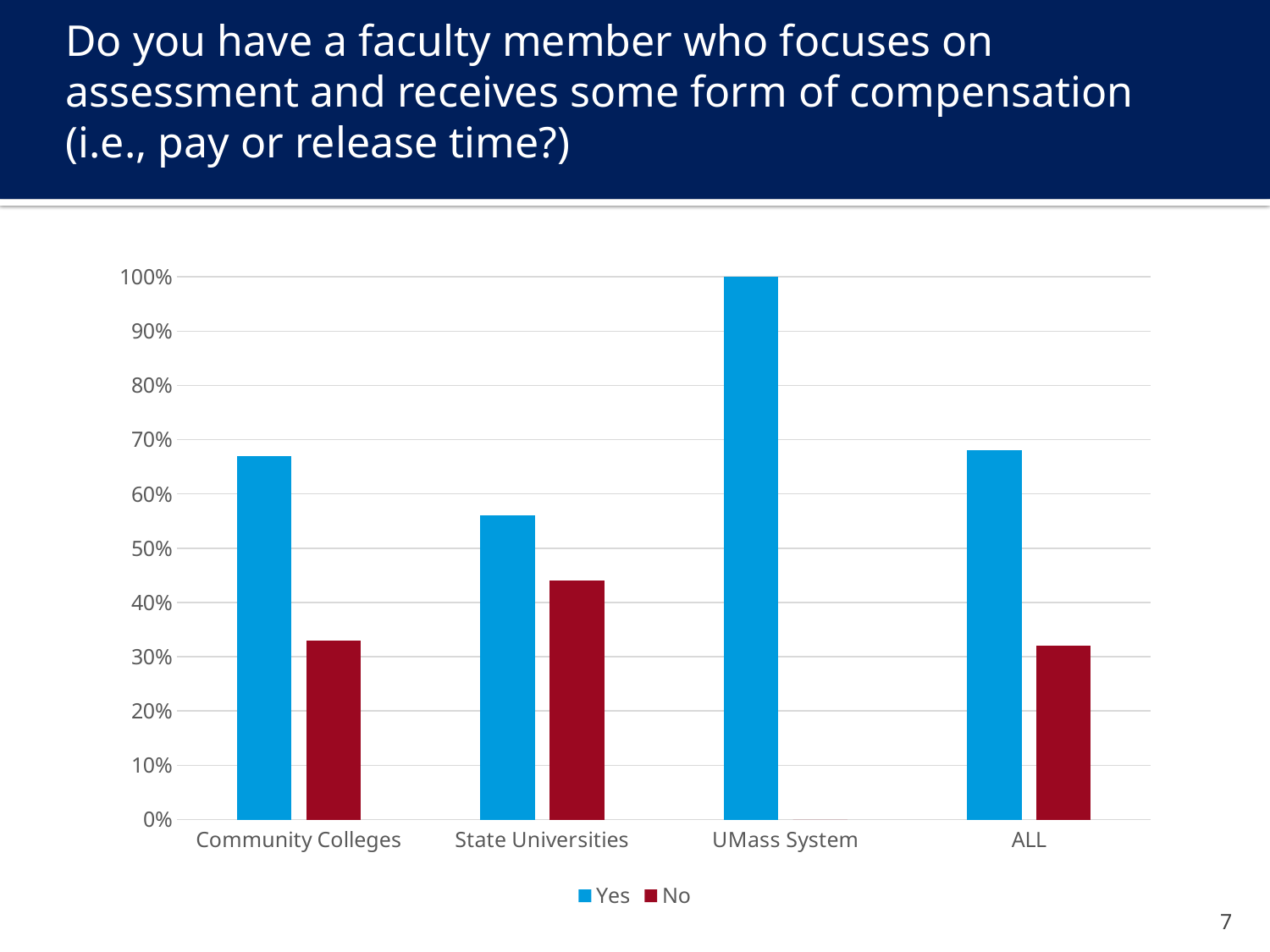
Is the Yes value for Community Colleges greater or less than 60%? greater Which category has the highest No value? State Universities How many categories are shown on the x axis? 4 How many series does the legend list? 2 Is the No value for State Universities greater or less than 50%? less What kind of chart is shown on the slide? bar chart What is the Yes value for UMass System? 100% Which category has the lowest Yes value? State Universities What colour are the Yes bars? blue For State Universities, which is larger, the Yes value or the No value? Yes Which category has the highest Yes value? UMass System